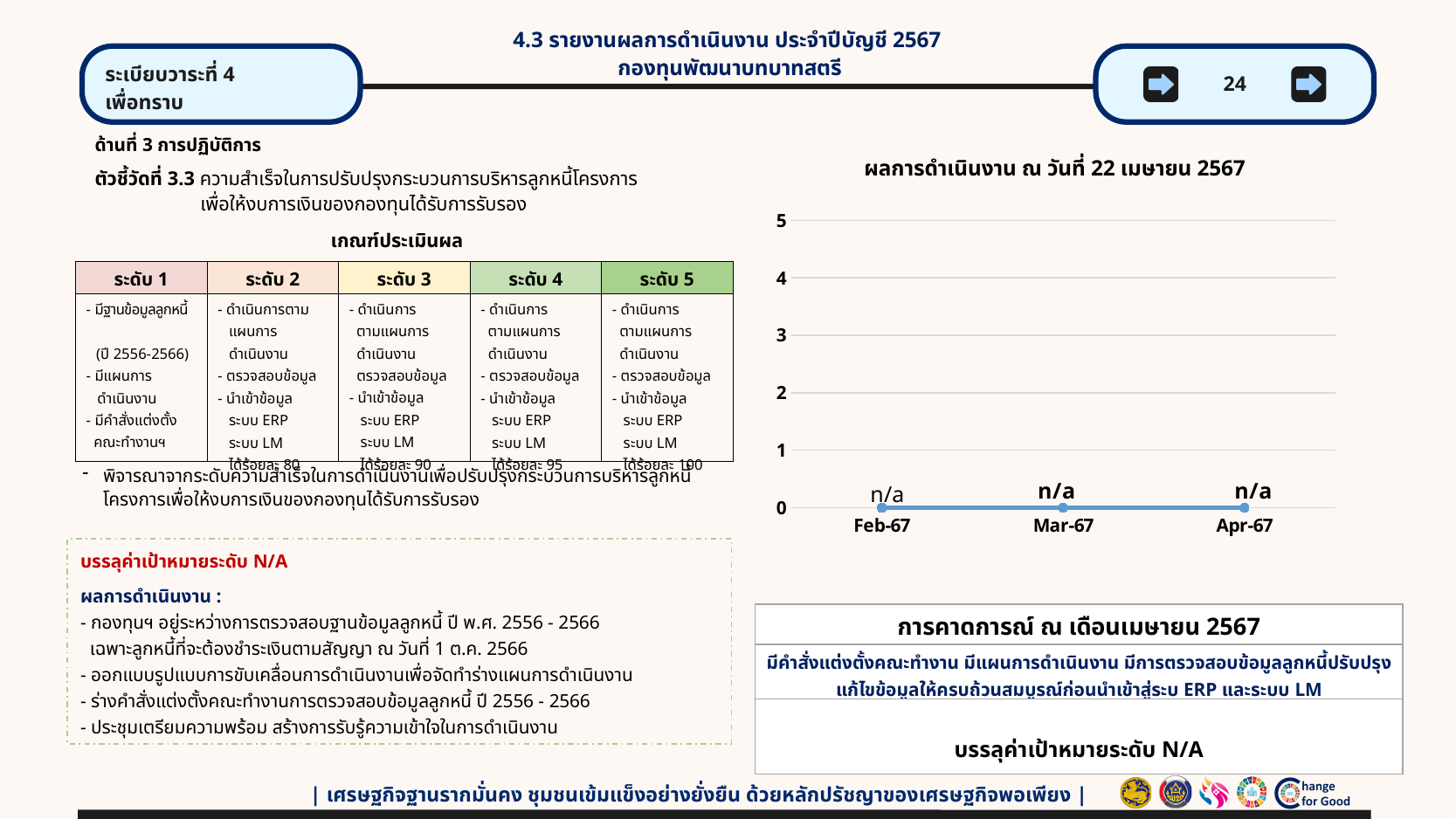
How many data points are plotted on the chart? 3 What is the highest tick value shown on the y axis of the chart? 5 Do the plotted values rise, fall, or stay flat from Feb-67 to Apr-67? stay flat What data label is shown for Mar-67 on the chart? n/a What data label is shown for Feb-67 on the chart? n/a What kind of chart is shown on the right side of the slide? line chart What data label is shown for Apr-67 on the chart? n/a Is the plotted point for Feb-67 greater or less than 2 on the y axis? less What is the title of the chart on the right side of the slide? ผลการดำเนินงาน ณ วันที่ 22 เมษายน 2567 Which categories appear on the x axis of the chart? Feb-67, Mar-67, Apr-67 Is the plotted point for Apr-67 greater or less than 1 on the y axis? less